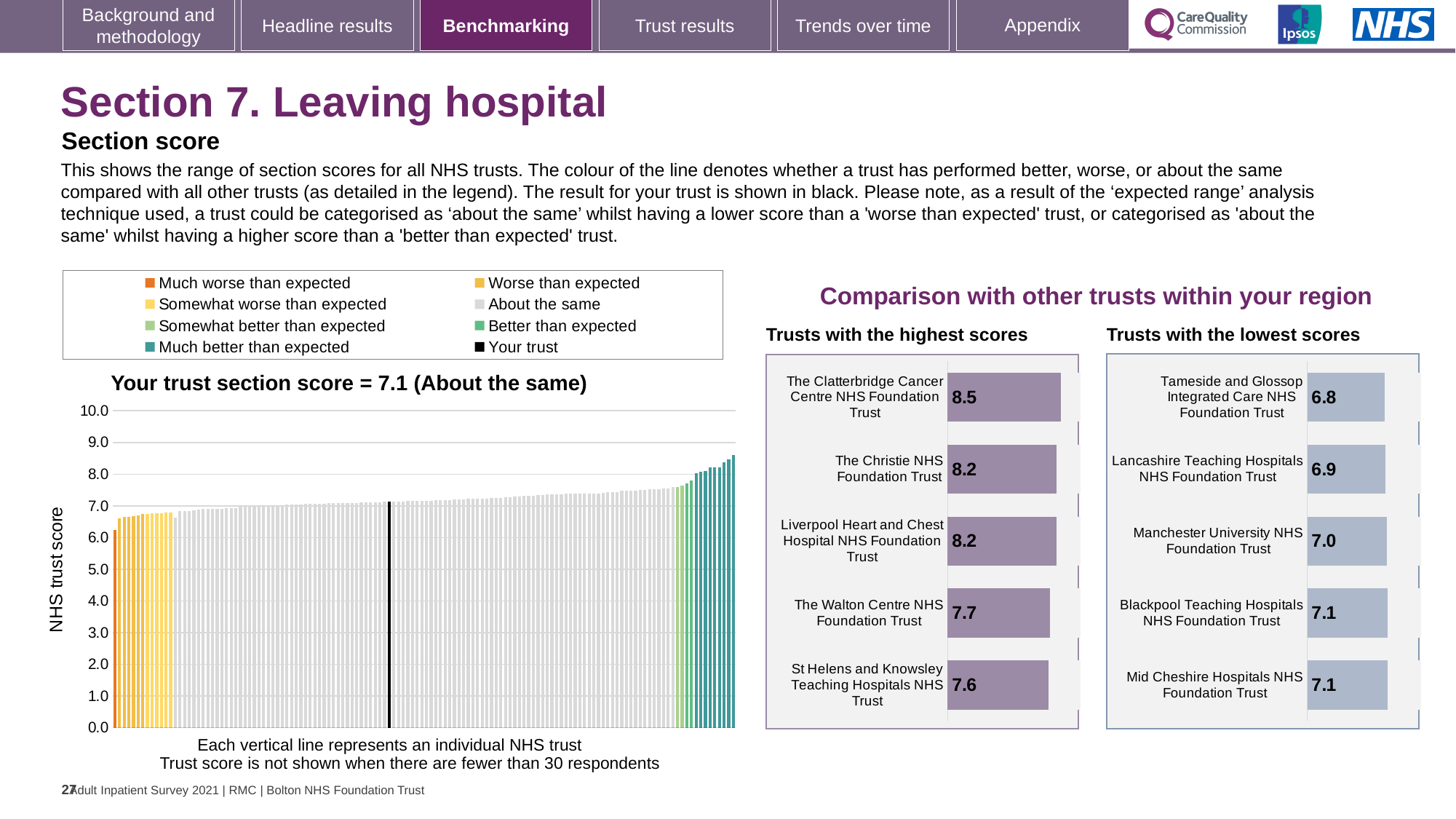
Which has the higher score: The Walton Centre NHS Foundation Trust in the 'highest scores' chart or Lancashire Teaching Hospitals NHS Foundation Trust in the 'lowest scores' chart? The Walton Centre NHS Foundation Trust How many trusts are shown in the 'Trusts with the highest scores' chart? 5 In the 'Trusts with the lowest scores' chart, what is the score for Manchester University NHS Foundation Trust? 7.0 In the 'Trusts with the lowest scores' chart, what is the score for Tameside and Glossop Integrated Care NHS Foundation Trust? 6.8 In the 'Trusts with the highest scores' chart, what is the difference between the scores of The Clatterbridge Cancer Centre NHS Foundation Trust and St Helens and Knowsley Teaching Hospitals NHS Trust? 0.9 In the 'Trusts with the highest scores' chart, which trust has the highest score? The Clatterbridge Cancer Centre NHS Foundation Trust How many entries does the legend above the large chart on the left list? 8 According to the title of the large chart on the left, what is your trust's section score? 7.1 (About the same) In the 'Trusts with the highest scores' chart, what is the score for The Clatterbridge Cancer Centre NHS Foundation Trust? 8.5 What kind of chart is the large chart on the left showing NHS trust scores? Bar chart In the 'Trusts with the lowest scores' chart, which trust has the lowest score? Tameside and Glossop Integrated Care NHS Foundation Trust In the 'Trusts with the lowest scores' chart, what is the difference between the scores of Mid Cheshire Hospitals NHS Foundation Trust and Tameside and Glossop Integrated Care NHS Foundation Trust? 0.3